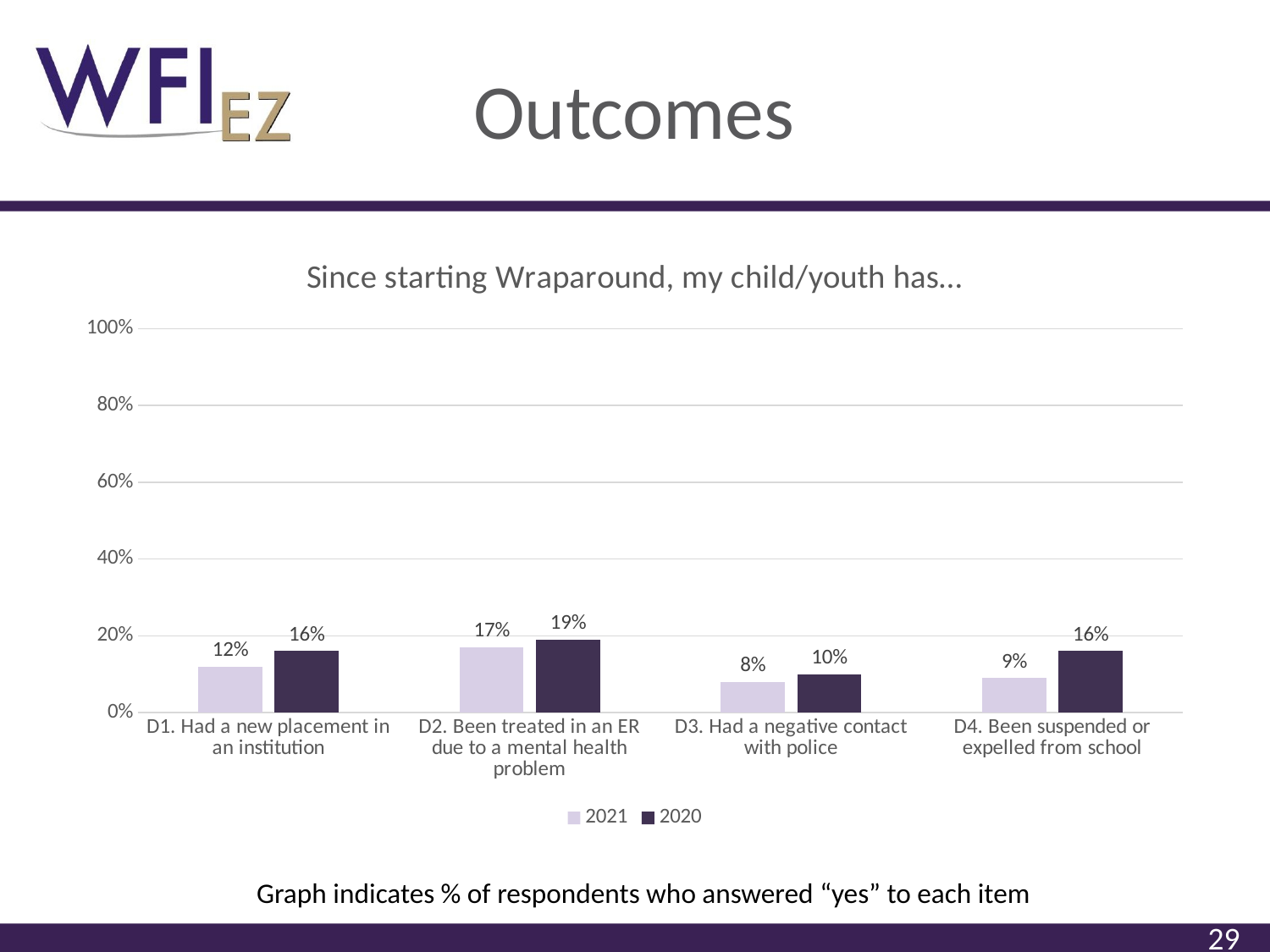
Is the 2020 value for D2. Been treated in an ER due to a mental health problem greater or less than 40%? less What is the 2021 value for D3. Had a negative contact with police? 8% What is the difference between the 2020 and 2021 values for D4. Been suspended or expelled from school? 7% How many categories are shown on the x axis? 4 What kind of chart is shown on the slide? bar chart What is the 2020 value for D4. Been suspended or expelled from school? 16% What is the 2021 value for D1. Had a new placement in an institution? 12% Which category has the lowest 2021 value? D3. Had a negative contact with police What is the 2020 value for D2. Been treated in an ER due to a mental health problem? 19% Which category has the highest 2020 value? D2. Been treated in an ER due to a mental health problem How many series does the legend list? 2 Which is larger for D1. Had a new placement in an institution: the 2021 value or the 2020 value? 2020